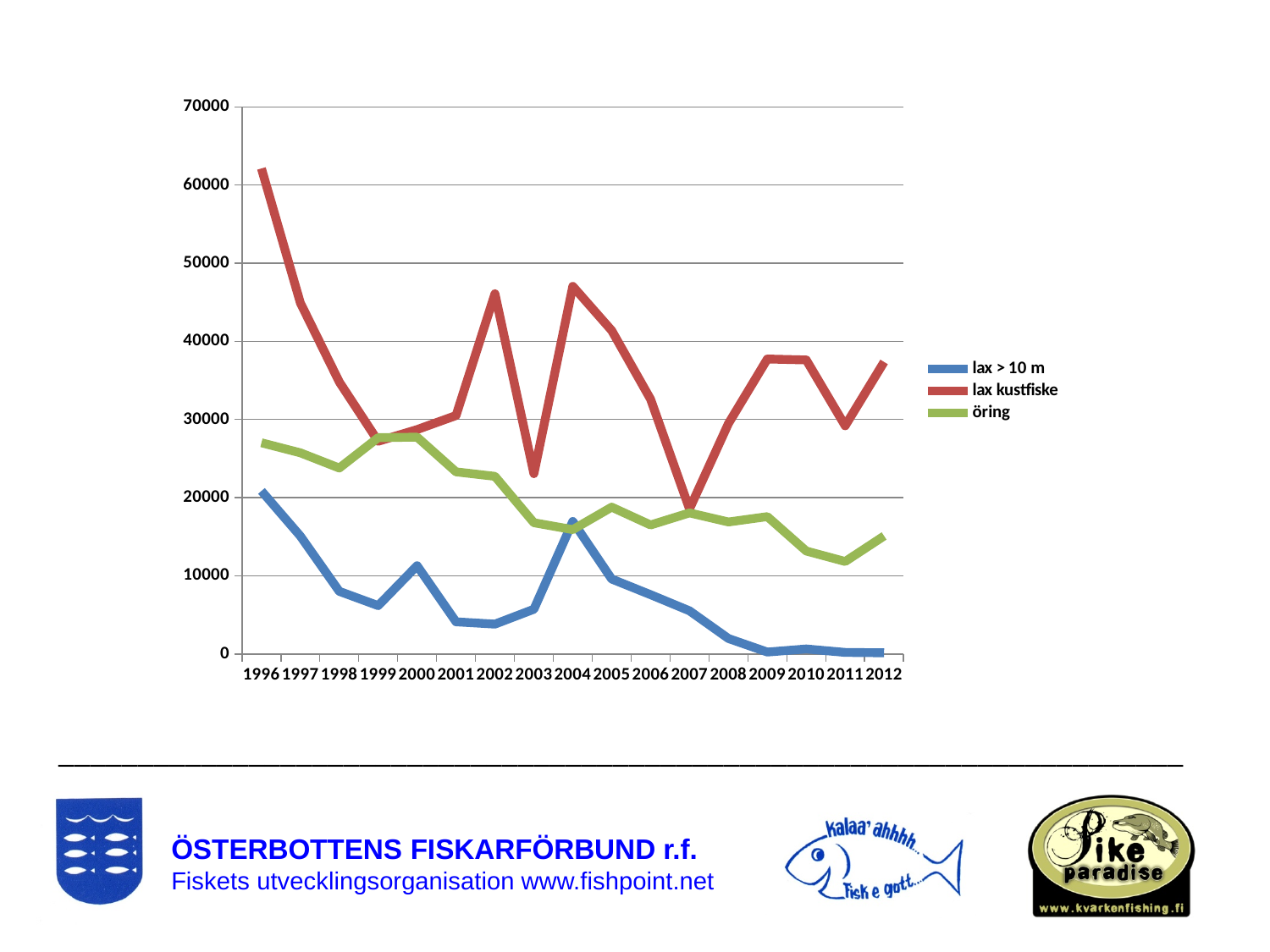
Is the value for lax kustfiske in 1996 greater or less than 50000? greater Is the value for lax > 10 m in 2009 greater or less than 10000? less In which year is the value for lax kustfiske lowest? 2007 Is the value for lax kustfiske in 2007 greater or less than 30000? less In which year is the value for lax kustfiske highest? 1996 Does the value for lax > 10 m generally rise or fall from 1996 to 2012? fall In 2012, which is larger: lax kustfiske or öring? lax kustfiske How many series does the legend list? 3 How many years are plotted along the x axis? 17 What colour is the line for öring? green What kind of chart is shown on the slide? line chart